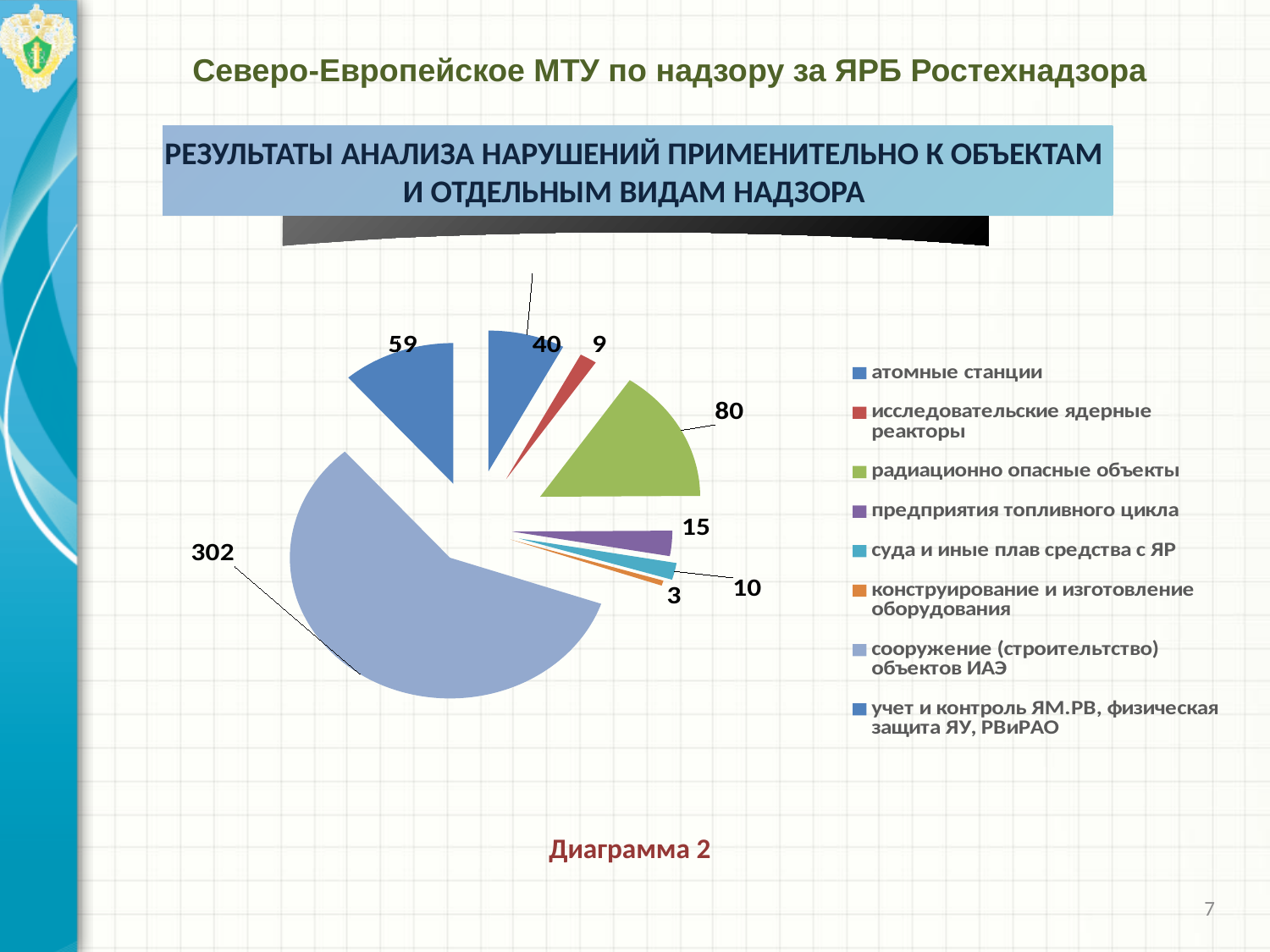
What is the value for «конструирование и изготовление оборудования»? 3 How many slices does the pie chart have? 8 What is the value for «атомные станции»? 40 What is the difference between the values for «учет и контроль ЯМ.РВ, физическая защита ЯУ, РВиРАО» and «атомные станции»? 19 Which category has the smallest slice? конструирование и изготовление оборудования What is the value for «сооружение (строительтство) объектов ИАЭ»? 302 What caption is shown below the chart? Диаграмма 2 How many entries does the legend list? 8 What kind of chart is shown on the slide? pie chart What is the value for «радиационно опасные объекты»? 80 Which is larger: the value for «предприятия топливного цикла» or for «суда и иные плав средства с ЯР»? предприятия топливного цикла Which category has the largest slice? сооружение (строительтство) объектов ИАЭ